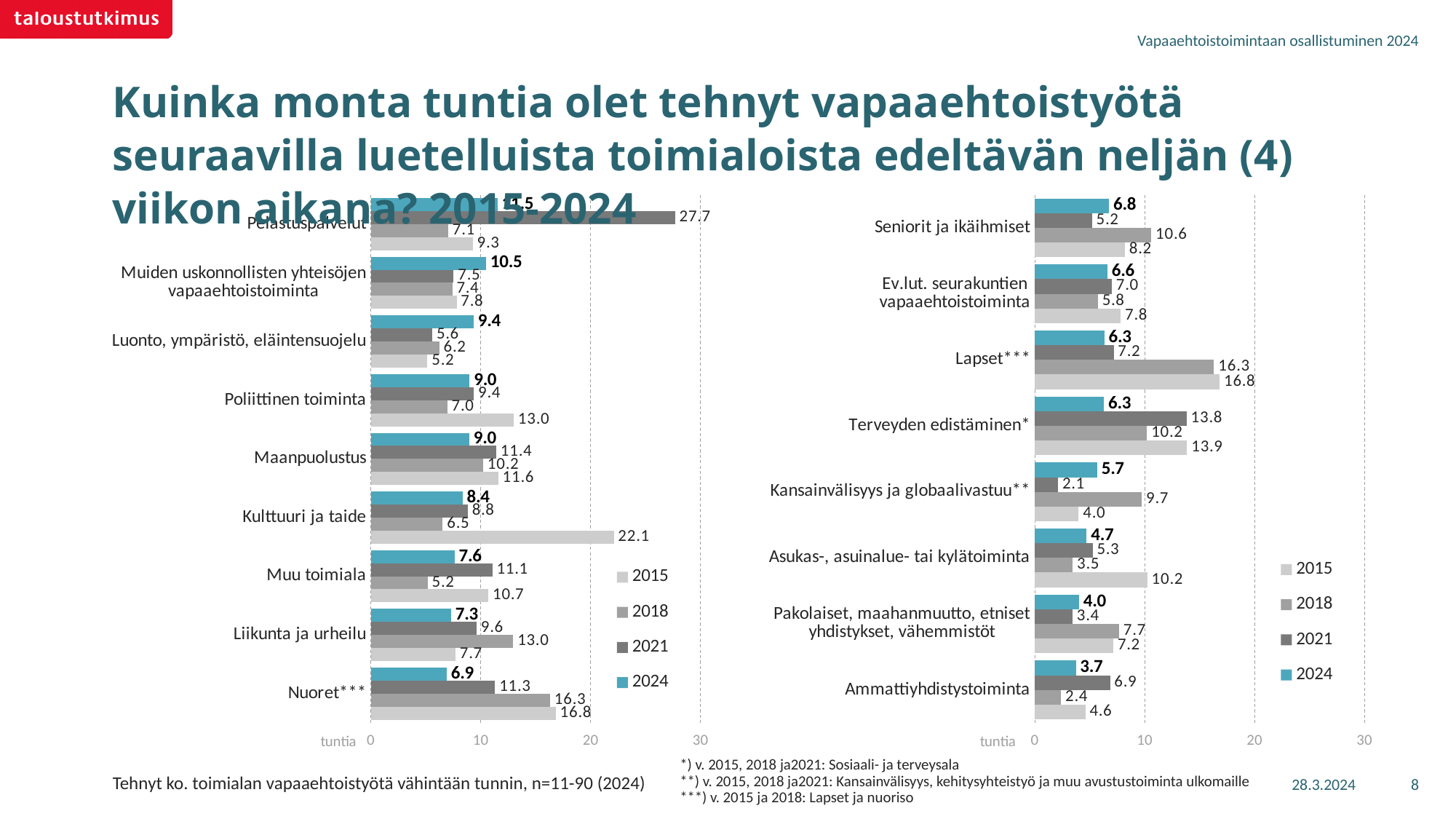
How many categories are shown in the left chart? 9 In the left chart, what is the difference between the 2015 and 2024 values for Nuoret***? 9.9 What kind of chart is used on this slide? bar chart In the right chart, what is the 2018 value for Kansainvälisyys ja globaalivastuu**? 9.7 In the right chart, what is the 2015 value for Lapset***? 16.8 In the left chart, is the 2015 value for Kulttuuri ja taide greater or less than 20? greater In the right chart, which category has the lowest 2024 value? Ammattiyhdistystoiminta In the right chart, for Terveyden edistäminen*, which year has the larger value: 2021 or 2018? 2021 Which years are listed in the legend of the left chart? 2015, 2018, 2021, 2024 In the left chart, what is the 2024 value for Liikunta ja urheilu? 7.3 How many series does the legend of the right chart list? 4 In the left chart, which category has the highest 2021 value? Pelastuspalvelut